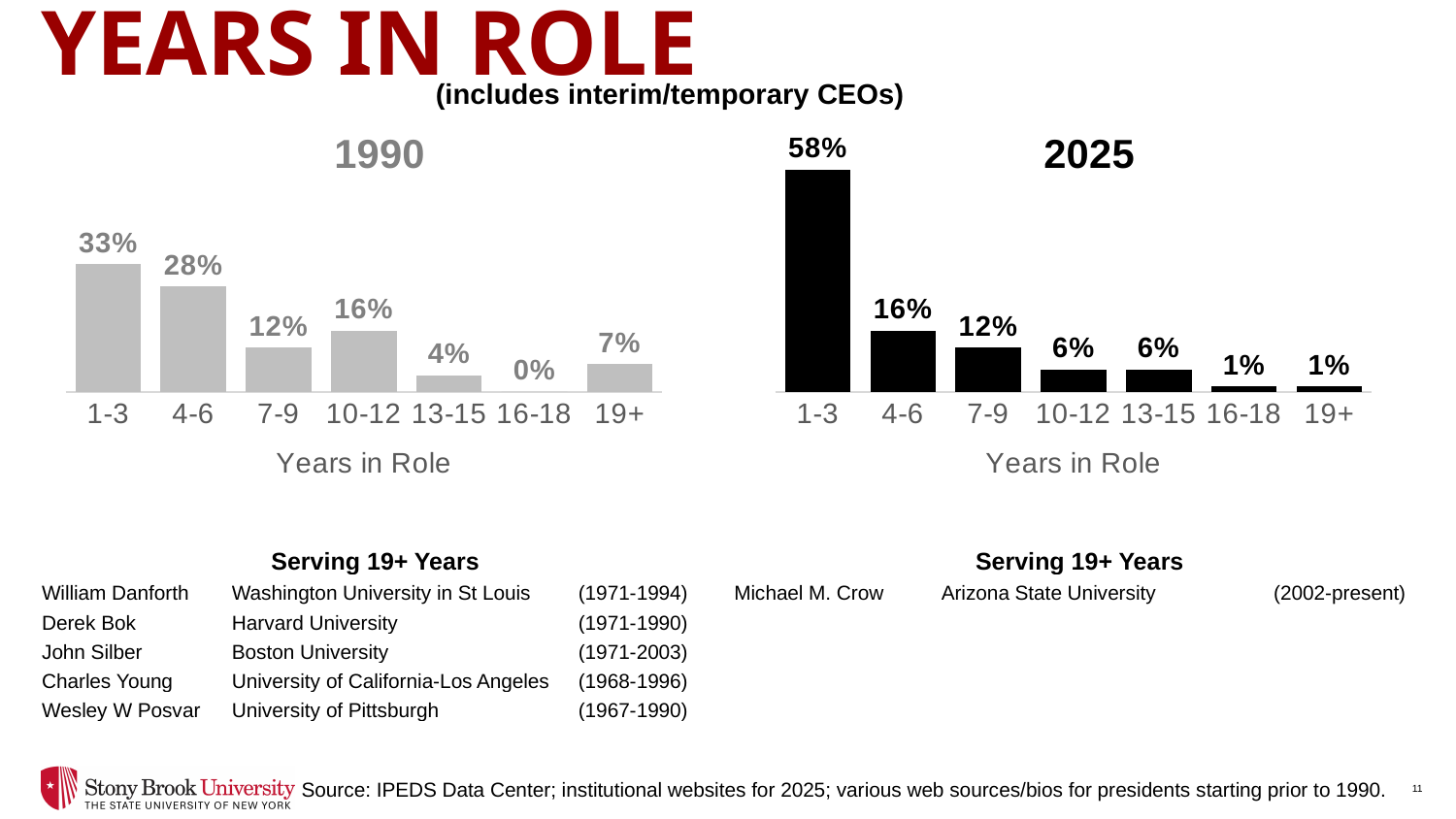
What kind of chart is the 1990 chart? Bar chart In the 2025 chart, do the values generally rise or fall from the 1-3 category to the 19+ category? Fall In the 1990 chart, which is larger, the value for 7-9 or the value for 10-12 years in role? 10-12 In the 2025 chart, what is the value for the 1-3 years in role category? 58% In the 1990 chart, which years-in-role category has the lowest value? 16-18 In the 1990 chart, what is the difference between the values for 1-3 and 4-6 years in role? 5% In the 1990 chart, what is the value for the 16-18 years in role category? 0% In the 2025 chart, which years-in-role category has the highest value? 1-3 In the 1990 chart, what is the value for the 1-3 years in role category? 33% In the 2025 chart, what is the difference between the values for 1-3 and 4-6 years in role? 42% What is the x-axis title of the 2025 chart? Years in Role How many years-in-role categories are shown in the 2025 chart? 7